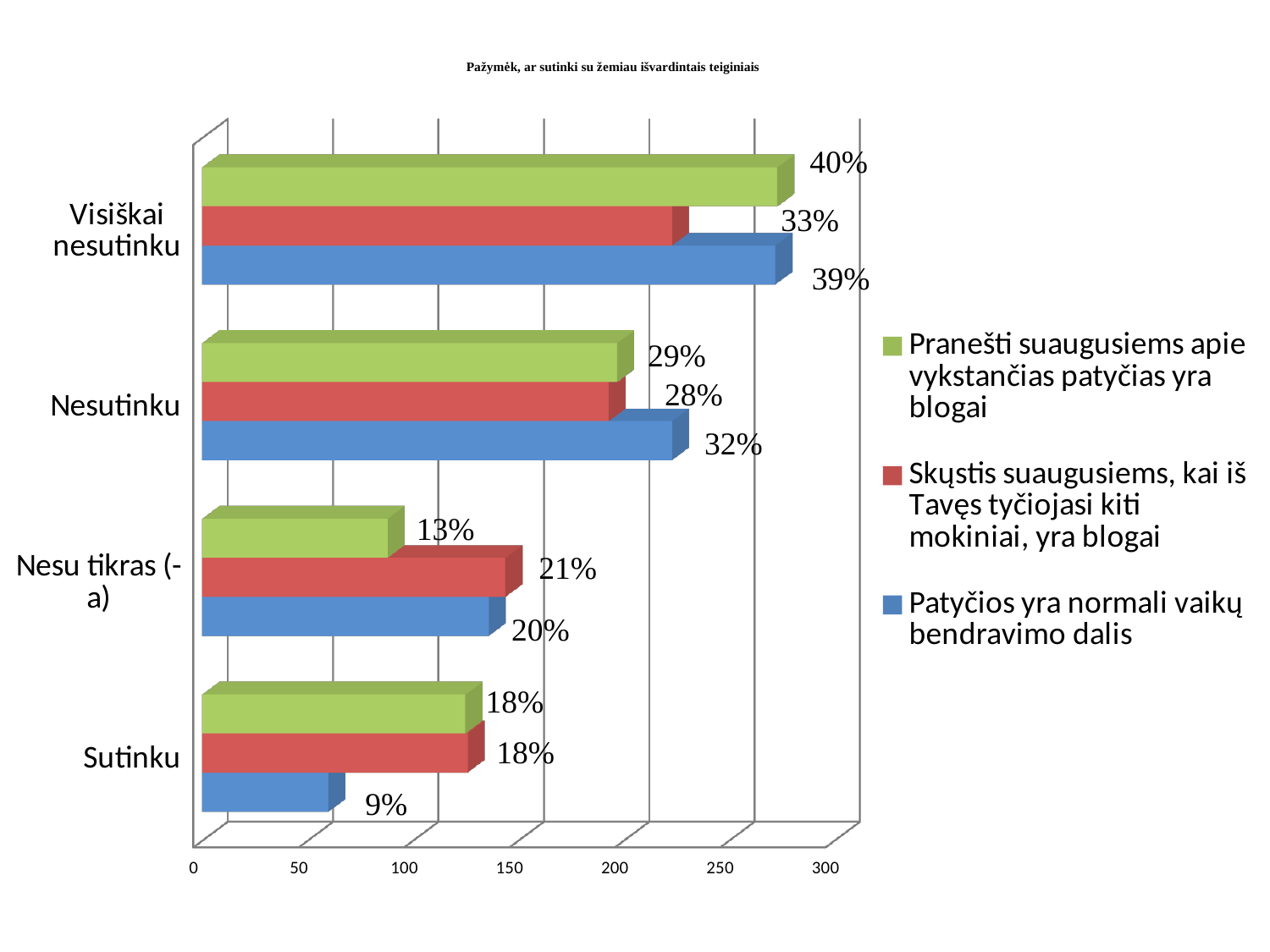
How many response categories are shown on the vertical axis? 4 In the 'Nesutinku' category, which series has the larger value: 'Patyčios yra normali vaikų bendravimo dalis' or 'Skųstis suaugusiems, kai iš Tavęs tyčiojasi kiti mokiniai, yra blogai'? Patyčios yra normali vaikų bendravimo dalis What is the title of the chart? Pažymėk, ar sutinki su žemiau išvardintais teiginiais How many series does the legend list? 3 Which category has the highest value for 'Patyčios yra normali vaikų bendravimo dalis'? Visiškai nesutinku What is the value for 'Skųstis suaugusiems, kai iš Tavęs tyčiojasi kiti mokiniai, yra blogai' in the 'Nesu tikras (-a)' category? 21% On the horizontal axis, is the bar for 'Patyčios yra normali vaikų bendravimo dalis' in the 'Sutinku' category greater or less than 100? less What is the value for 'Pranešti suaugusiems apie vykstančias patyčias yra blogai' in the 'Visiškai nesutinku' category? 40% What kind of chart is shown on the slide? bar chart What is the difference between the 'Visiškai nesutinku' values for 'Pranešti suaugusiems apie vykstančias patyčias yra blogai' and 'Skųstis suaugusiems, kai iš Tavęs tyčiojasi kiti mokiniai, yra blogai'? 7% What is the value for 'Patyčios yra normali vaikų bendravimo dalis' in the 'Sutinku' category? 9% Which category has the lowest value for 'Pranešti suaugusiems apie vykstančias patyčias yra blogai'? Nesu tikras (-a)